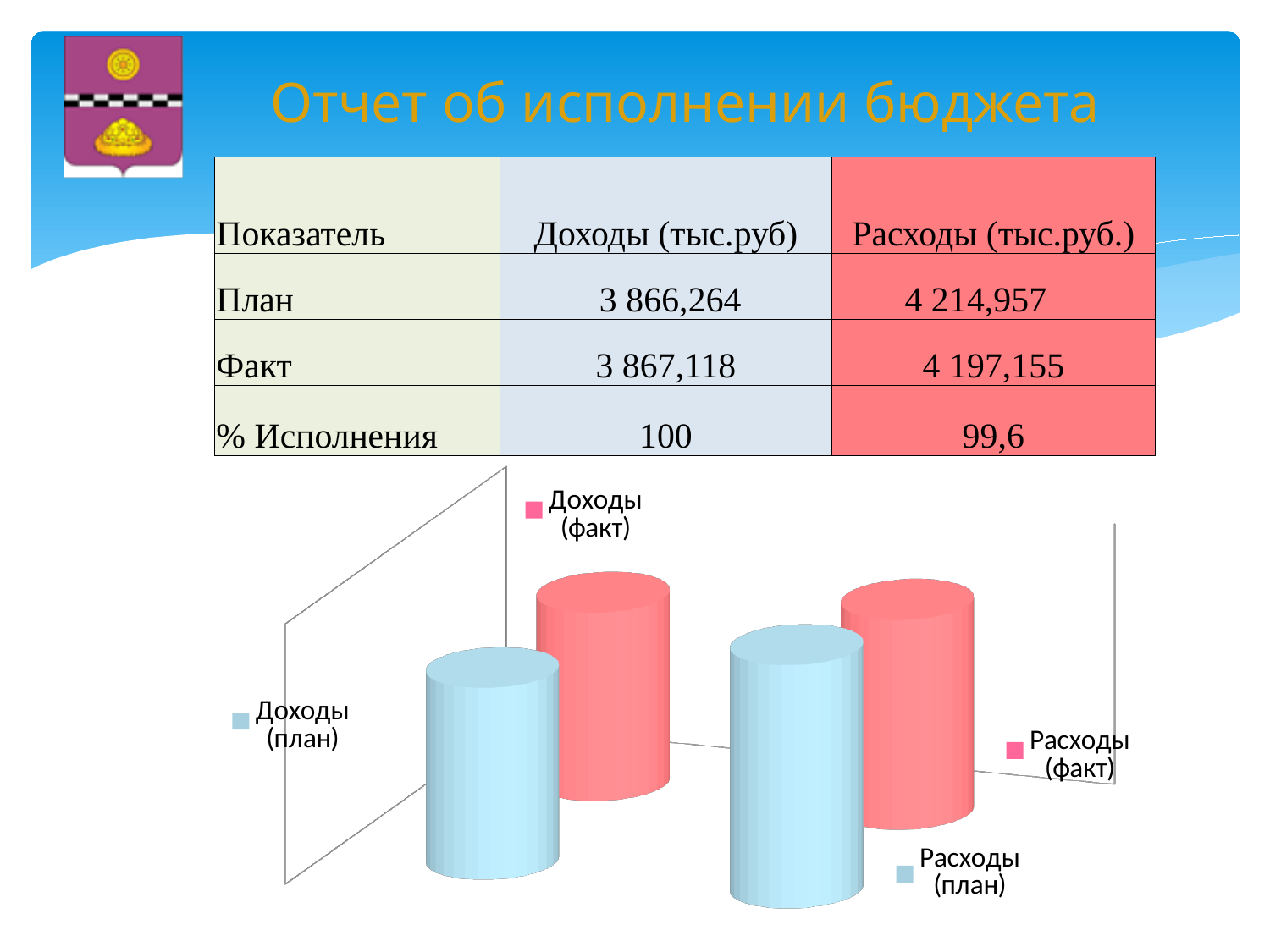
According to the table above the chart, what is the actual income (Доходы, Факт) in тыс.руб? 3 867,118 What kind of chart is shown on the slide? bar chart Using the table values, what is the difference between planned and actual expenditure (Расходы План minus Расходы Факт) in тыс.руб? 17,802 Using the table values, by how much does actual income exceed planned income (Доходы Факт minus Доходы План) in тыс.руб? 0,854 What is the title of the slide containing the chart? Отчет об исполнении бюджета How many bars are plotted in the chart? 4 According to the table above the chart, what is the actual expenditure (Расходы, Факт) in тыс.руб? 4 197,155 According to the table above the chart, what is the planned expenditure (Расходы, План) in тыс.руб? 4 214,957 According to the table, what is the % Исполнения for Расходы? 99,6 According to the table above the chart, what is the planned income (Доходы, План) in тыс.руб? 3 866,264 What colour are the bars for the planned values (план) in the chart? light blue